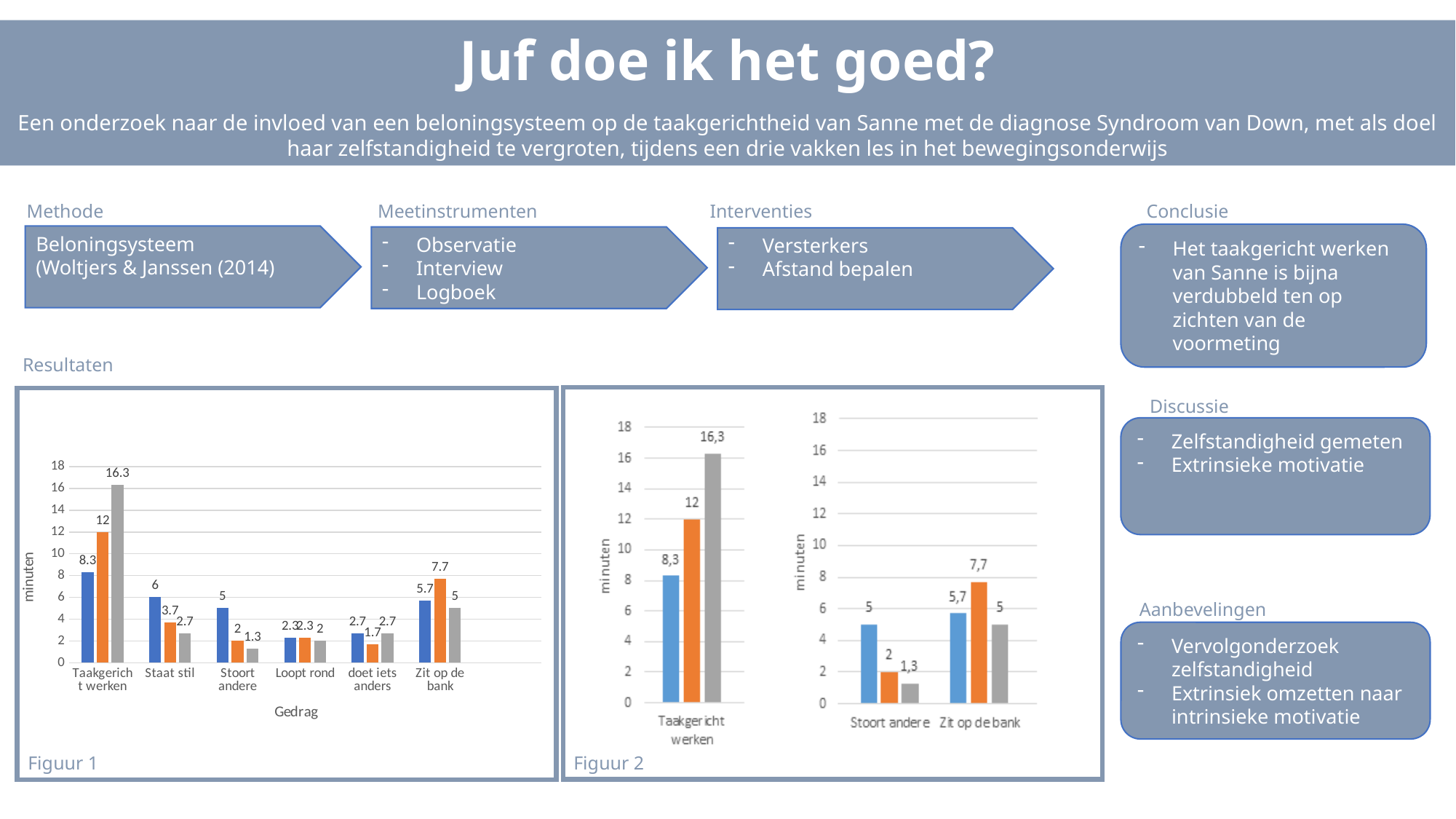
In Figuur 1, do the three bars for 'Taakgericht werken' rise or fall from blue to grey? rise In Figuur 1, what is the value of the grey bar for 'Taakgericht werken'? 16.3 In Figuur 1, which category has the lowest grey bar? Stoort andere In Figuur 2, what is the difference between the orange bar and the grey bar for 'Zit op de bank'? 2,7 In Figuur 1, how many categories are shown on the x axis? 6 In Figuur 1, which category has the highest grey bar? Taakgericht werken In Figuur 1, what is the difference between the grey bar and the blue bar for 'Taakgericht werken'? 8 In Figuur 1, which is larger for 'Staat stil': the blue bar or the orange bar? the blue bar In Figuur 2, what is the value of the orange bar for 'Stoort andere'? 2 What kind of chart is Figuur 1? bar chart In Figuur 1, what is the value of the orange bar for 'Zit op de bank'? 7.7 What is the label of the y axis in Figuur 1? minuten